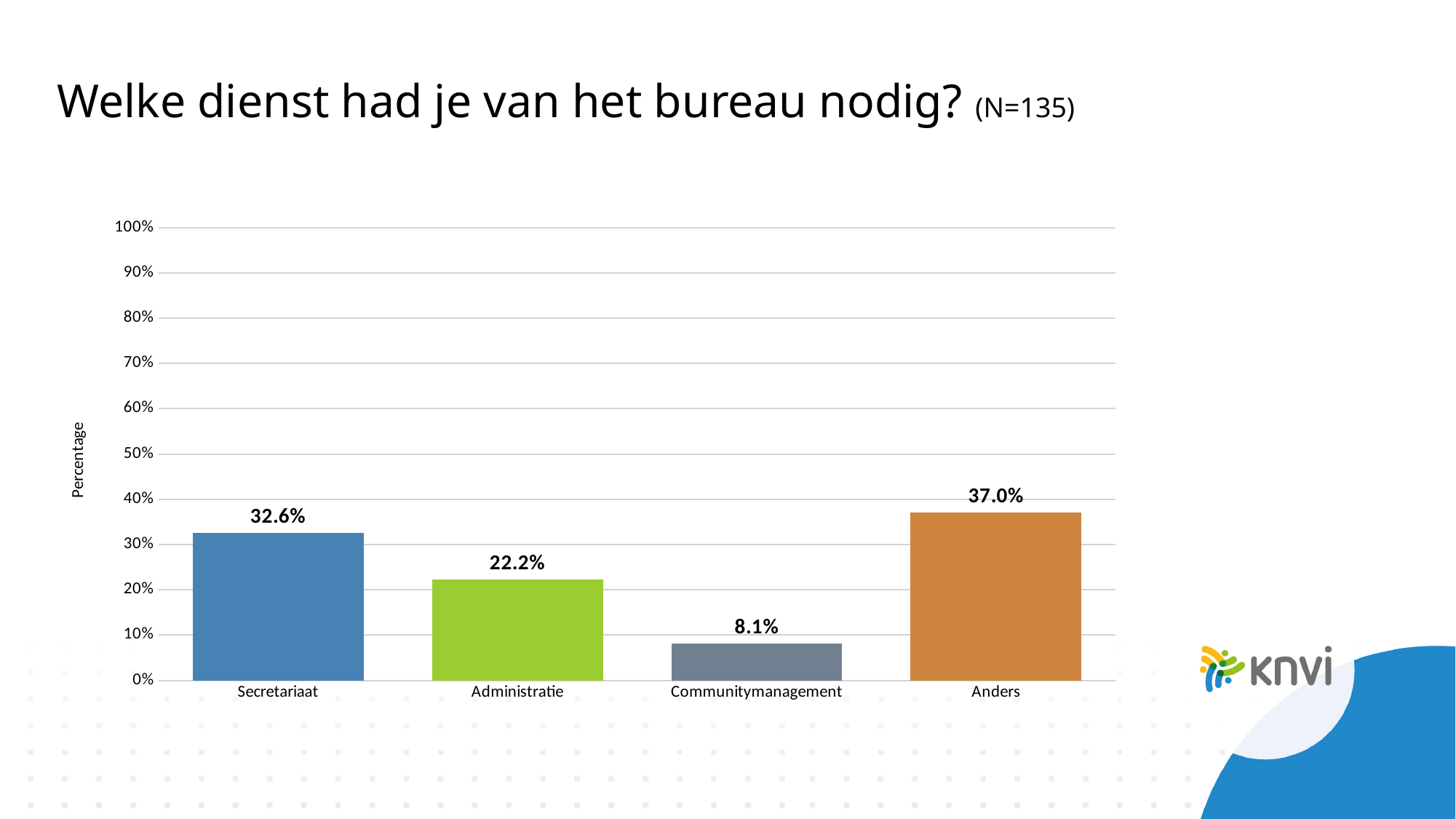
Which category has the highest percentage? Anders Is the value for Secretariaat greater or less than 30%? greater What percentage is shown for Secretariaat? 32.6% What is the difference in percentage points between Anders and Secretariaat? 4.4 How many categories are shown on the x axis? 4 What percentage is shown for Administratie? 22.2% What kind of chart is shown on the slide? bar chart What percentage is shown for Anders? 37.0% Which category has the lowest percentage? Communitymanagement What percentage is shown for Communitymanagement? 8.1% What is the label of the vertical axis? Percentage Which is larger, the value for Administratie or the value for Communitymanagement? Administratie